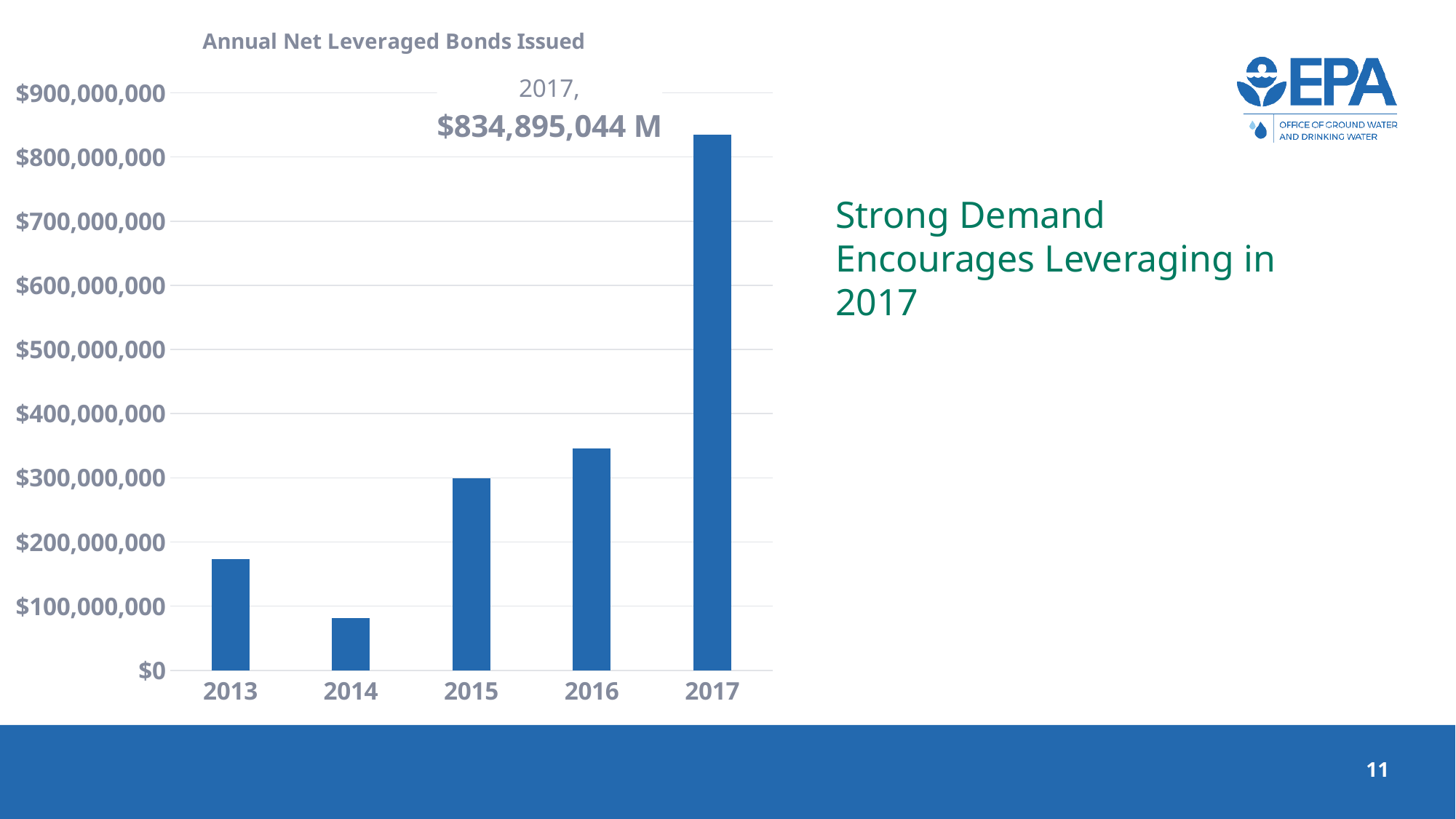
Which year has the highest value in the chart? 2017 What is the value labelled for 2017 in the chart? $834,895,044 M Is the value for 2013 greater or less than $200,000,000? less What kind of chart is shown on the slide? bar chart Is the value for 2017 greater or less than $800,000,000? greater How many years are shown on the x axis of the chart? 5 Do the values rise or fall from 2014 to 2017? rise Which year has the larger value, 2015 or 2016? 2016 Is the value for 2014 greater or less than $100,000,000? less What is the title of the chart? Annual Net Leveraged Bonds Issued Which year has the lowest value in the chart? 2014